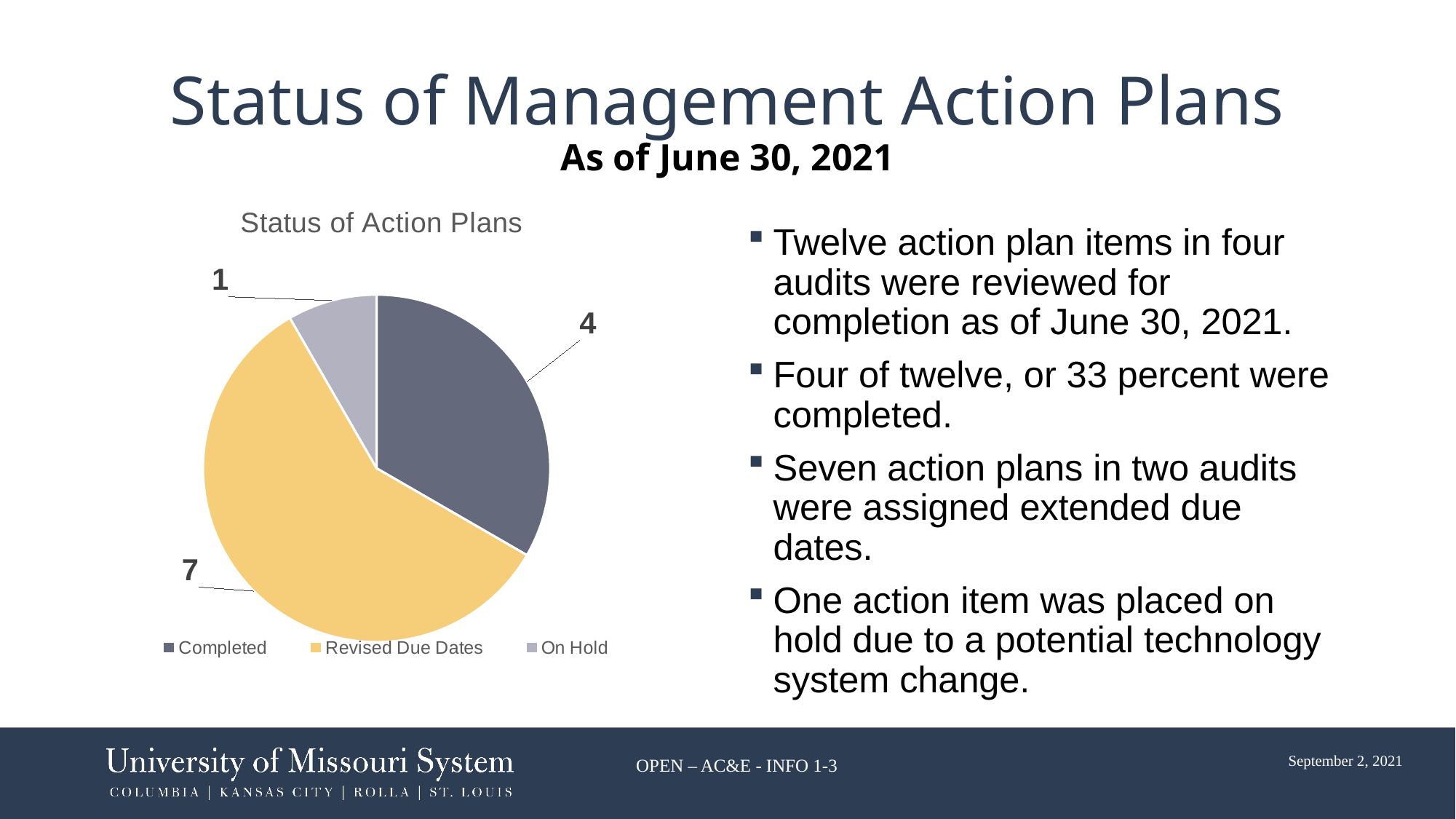
How many more action plans have Revised Due Dates than are Completed? 3 How many action plans are shown as On Hold in the chart? 1 What is the title of the chart? Status of Action Plans Which category has the largest slice in the pie chart? Revised Due Dates How many categories does the pie chart show? 3 What kind of chart is shown on the slide? Pie chart What is the total number of action plans across all slices of the pie chart? 12 How many action plans are shown as Completed in the chart? 4 Which is larger: the number of Completed action plans or the number On Hold? Completed Which category has the smallest slice in the pie chart? On Hold How many action plans are shown with Revised Due Dates in the chart? 7 Which category is shown in yellow in the pie chart? Revised Due Dates